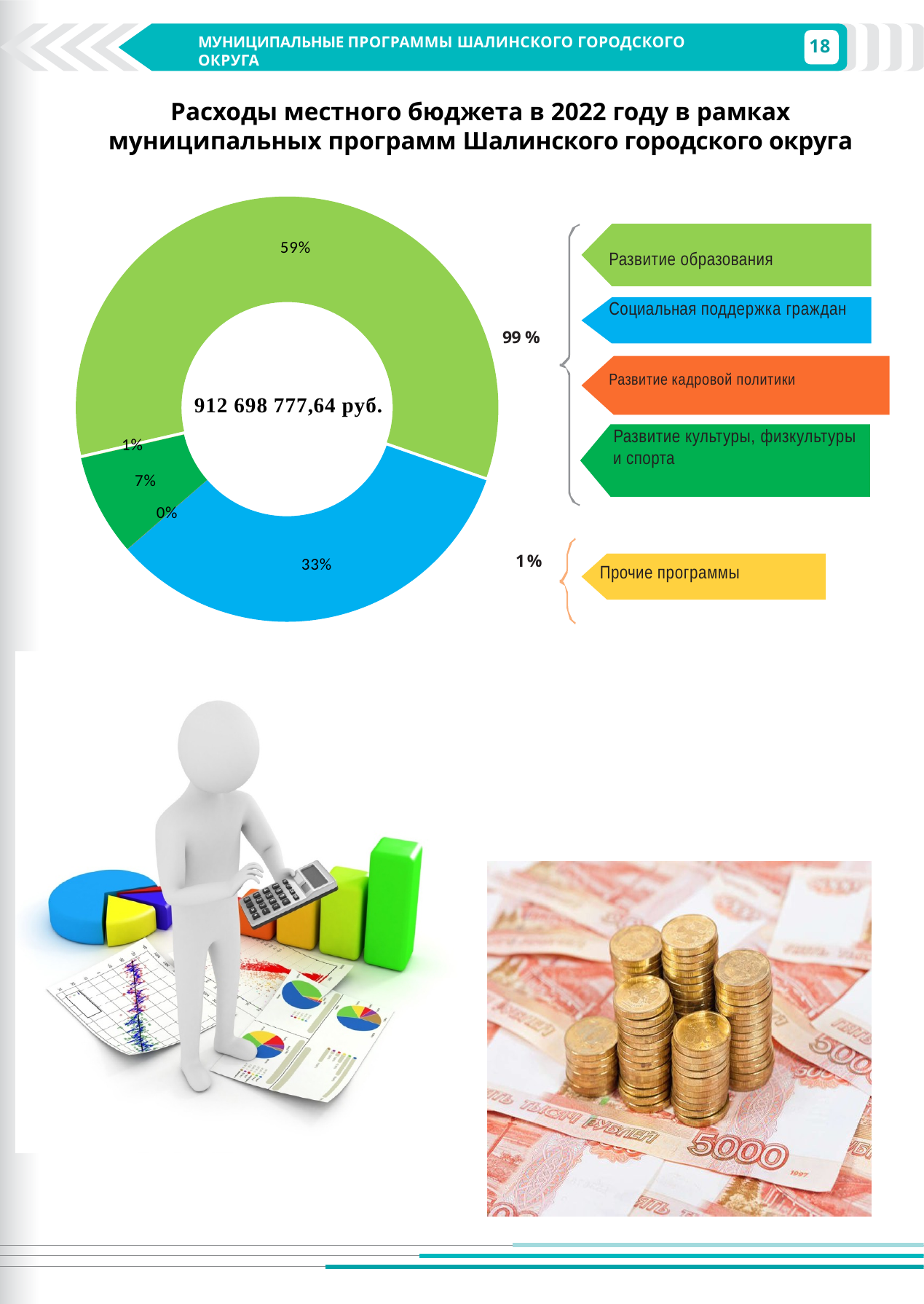
Which program has the largest share of the budget expenditure? Развитие образования Which has a larger share: Социальная поддержка граждан or Развитие культуры, физкультуры и спорта? Социальная поддержка граждан How many programs (categories) does the legend list? 5 What percentage is shown for Развитие кадровой политики? 0% What total amount is shown in the centre of the donut chart? 912 698 777,64 руб. What share of the budget expenditure goes to Развитие культуры, физкультуры и спорта? 7% Which program has the smallest share of the budget expenditure? Развитие кадровой политики What share of the budget expenditure goes to Прочие программы? 1% What is the difference in percentage points between Развитие образования and Социальная поддержка граждан? 26 What share of the budget expenditure goes to Развитие образования? 59% What share of the budget expenditure goes to Социальная поддержка граждан? 33% What type of chart is shown on the slide? Donut (pie) chart